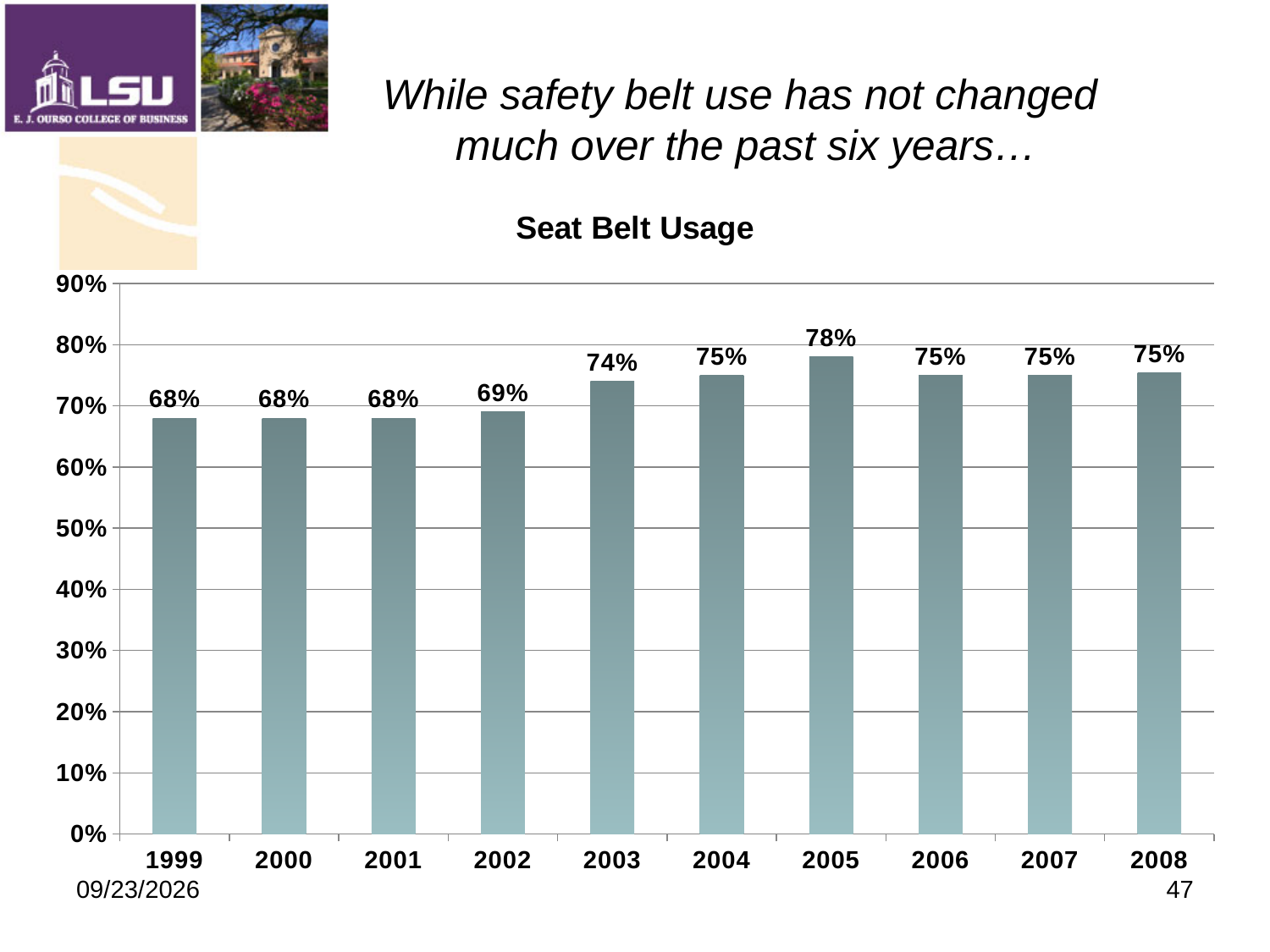
What is the difference in seat belt usage between 2003 and 2002? 5% What kind of chart is shown on the slide? bar chart What is the title of the chart? Seat Belt Usage What is the seat belt usage value for 1999? 68% Which year has the highest seat belt usage? 2005 How many years are shown on the x axis of the chart? 10 Which year has the larger seat belt usage, 2003 or 2005? 2005 What is the difference in seat belt usage between 2005 and 1999? 10% Does seat belt usage rise or fall from 1999 to 2005? rise Is the seat belt usage value for 2008 greater or less than 70%? greater What is the seat belt usage value for 2005? 78% What is the seat belt usage value for 2002? 69%